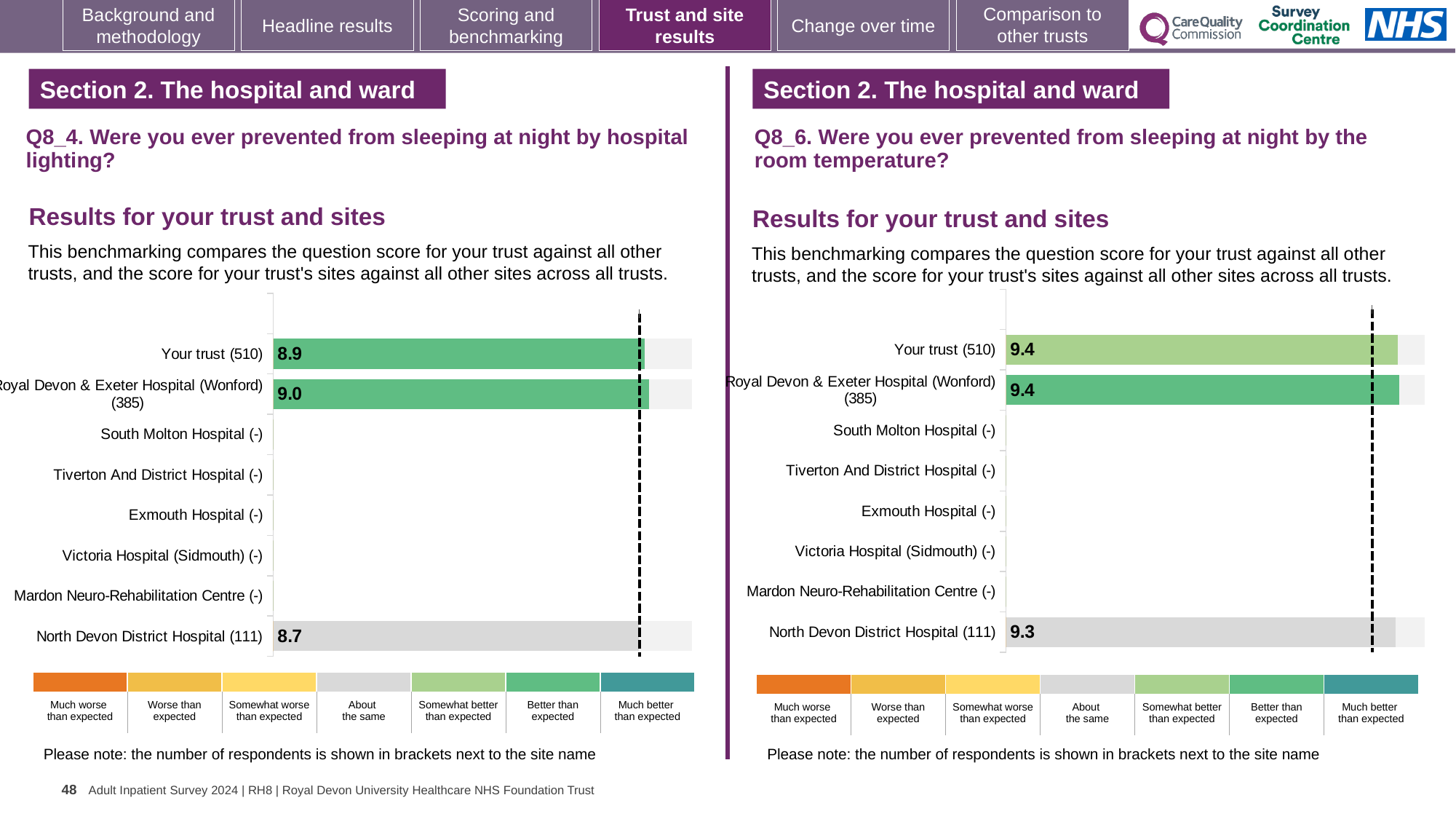
What kind of chart is used in the Q8_6 chart (room temperature)? Bar chart In the Q8_6 chart (room temperature), what is the score for Your trust (510)? 9.4 In the Q8_6 chart (room temperature), which is larger: the score for Your trust or the score for North Devon District Hospital? Your trust In the Q8_4 chart (hospital lighting), which site has the lowest score? North Devon District Hospital In the Q8_4 chart (hospital lighting), what is the score for Royal Devon & Exeter Hospital (Wonford) (385)? 9.0 In the Q8_4 chart (hospital lighting), what is the score for Your trust (510)? 8.9 In the Q8_6 chart (room temperature), what is the difference between the scores for Your trust and North Devon District Hospital? 0.1 In the Q8_4 chart (hospital lighting), what is the difference between the scores for Royal Devon & Exeter Hospital (Wonford) and North Devon District Hospital? 0.3 In the Q8_4 chart (hospital lighting), what is the score for North Devon District Hospital (111)? 8.7 In the Q8_4 chart (hospital lighting), which site has the highest score? Royal Devon & Exeter Hospital (Wonford) In the Q8_6 chart (room temperature), what is the score for North Devon District Hospital (111)? 9.3 How many site/trust rows are listed on the y axis of the Q8_4 chart (hospital lighting)? 8